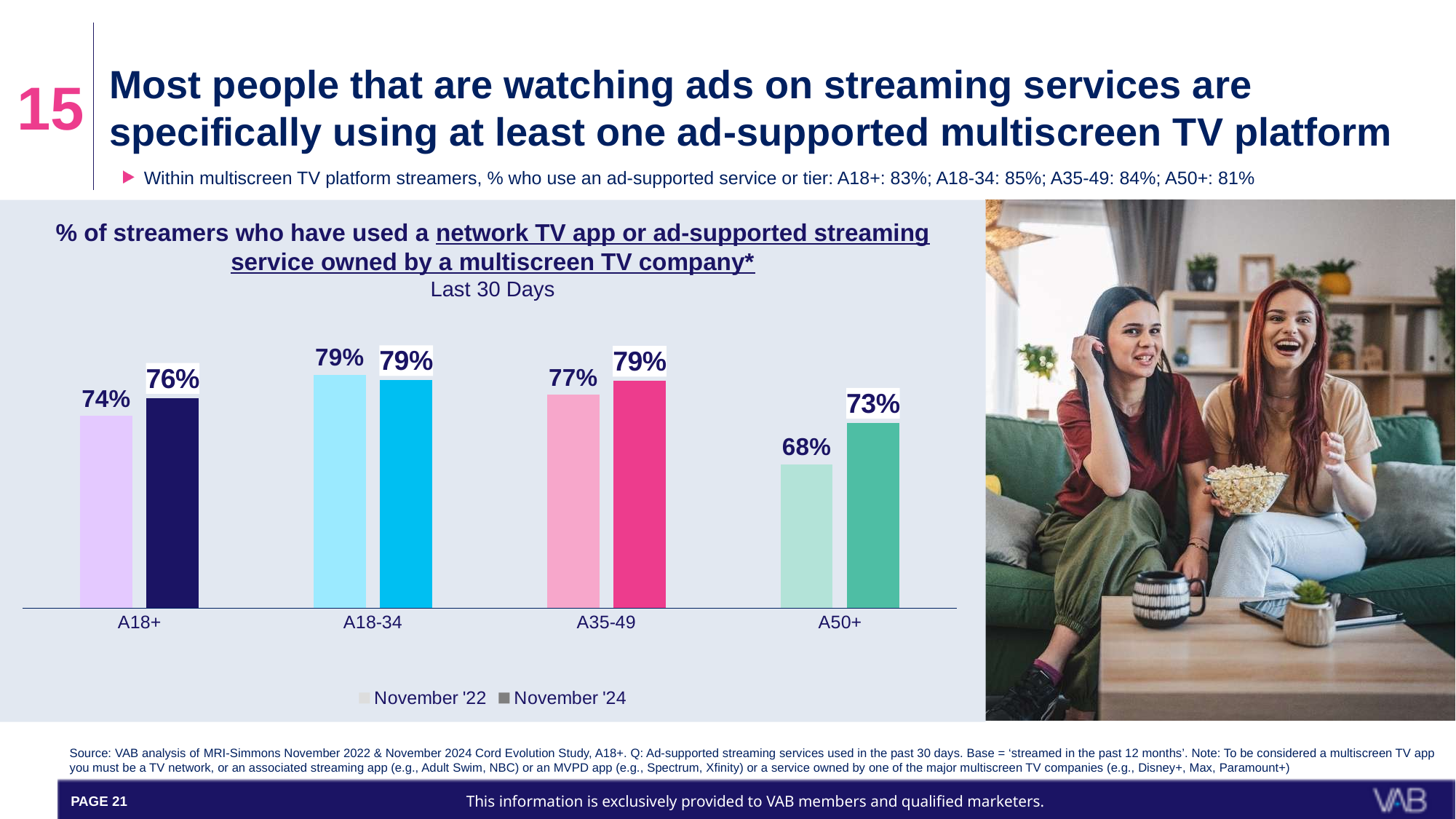
What is the November '22 value for A50+? 68% How many age groups are shown on the x axis? 4 What kind of chart is shown on the slide? Bar chart Which is larger for A18+: the November '22 value or the November '24 value? November '24 Which age group has the lowest November '24 value? A50+ What is the November '24 value for A18+? 76% What is the November '24 value for A18-34? 79% Which age group has the highest November '22 value? A18-34 What is the difference between the November '24 and November '22 values for A35-49? 2% What is the difference between the November '24 and November '22 values for A50+? 5% What is the November '22 value for A35-49? 77% How many series does the legend list? 2